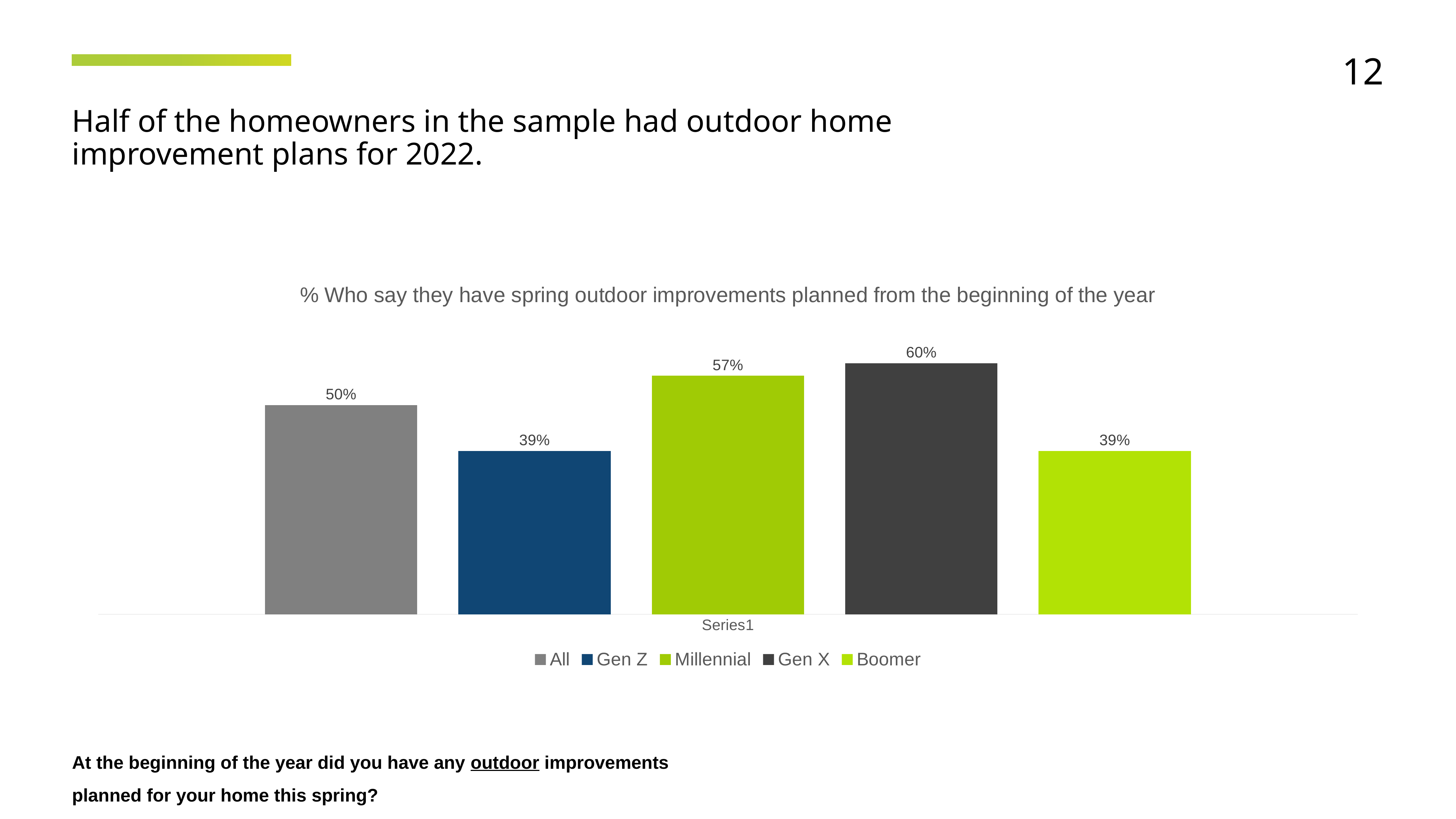
How many series does the legend list? 5 Which group has the highest percentage with spring outdoor improvements planned? Gen X What is the value shown for Millennial? 57% What is the difference between the Gen X value and the Gen Z value? 21% What percentage of all homeowners say they have spring outdoor improvements planned? 50% What is the value shown for Gen X? 60% What is the difference between the Millennial value and the All value? 7% What is the value shown for Gen Z? 39% What is the title of the chart? % Who say they have spring outdoor improvements planned from the beginning of the year What kind of chart is shown on the slide? Bar chart How many bars are plotted in the chart? 5 Which is larger, the value for Millennial or the value for Boomer? Millennial